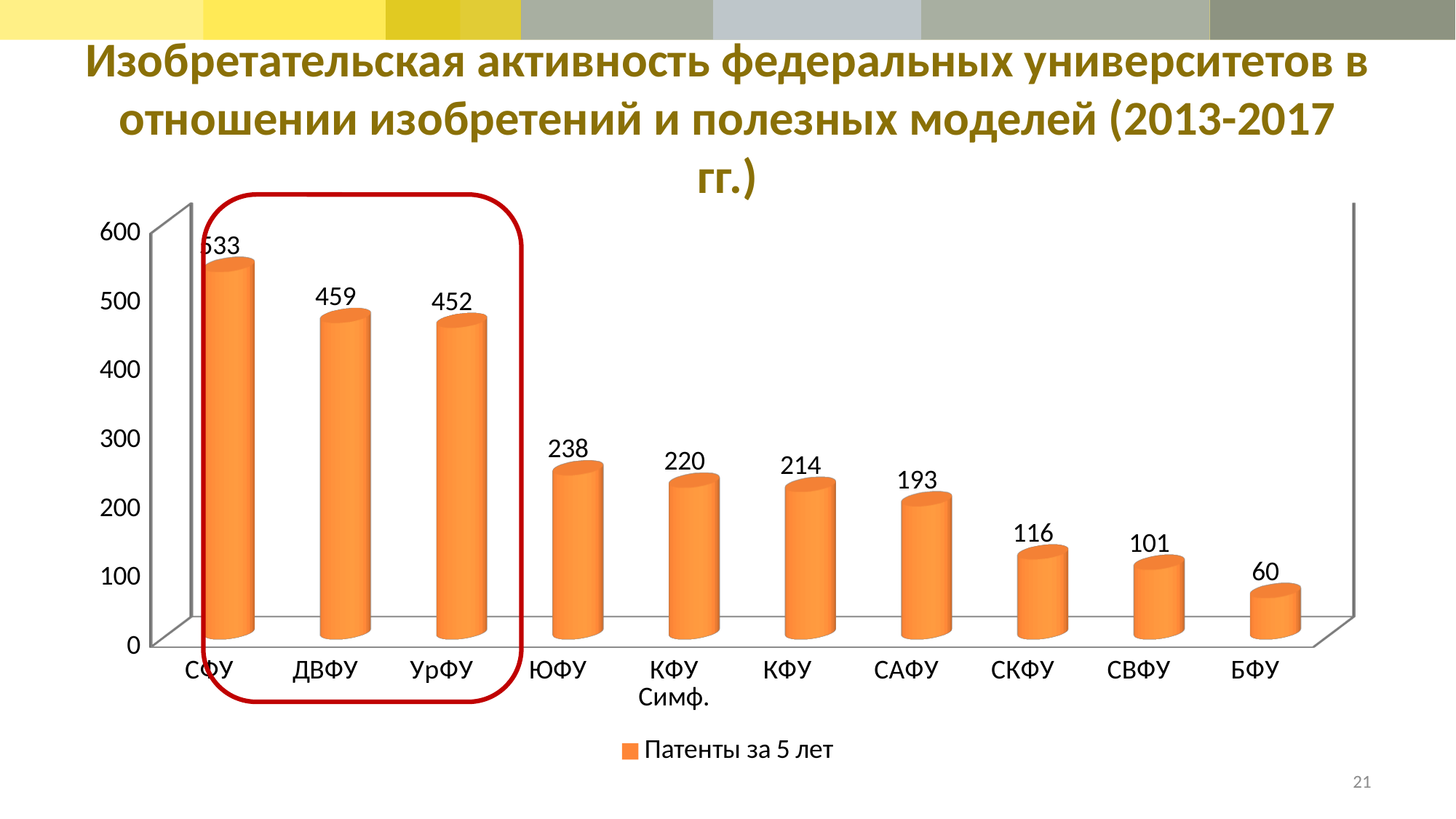
What is the value for ЮФУ? 238 What is the value for ДВФУ? 459 Which university has the lowest value? БФУ What is the difference between the values for ДВФУ and УрФУ? 7 Which university has the highest value? СФУ What is the difference between the values for САФУ and СВФУ? 92 How many universities are shown on the x axis? 10 What is the value for КФУ Симф.? 220 What series does the legend list? Патенты за 5 лет What is the value for СКФУ? 116 Which is larger, the value for ЮФУ or the value for КФУ? ЮФУ What kind of chart is shown on the slide? Bar chart